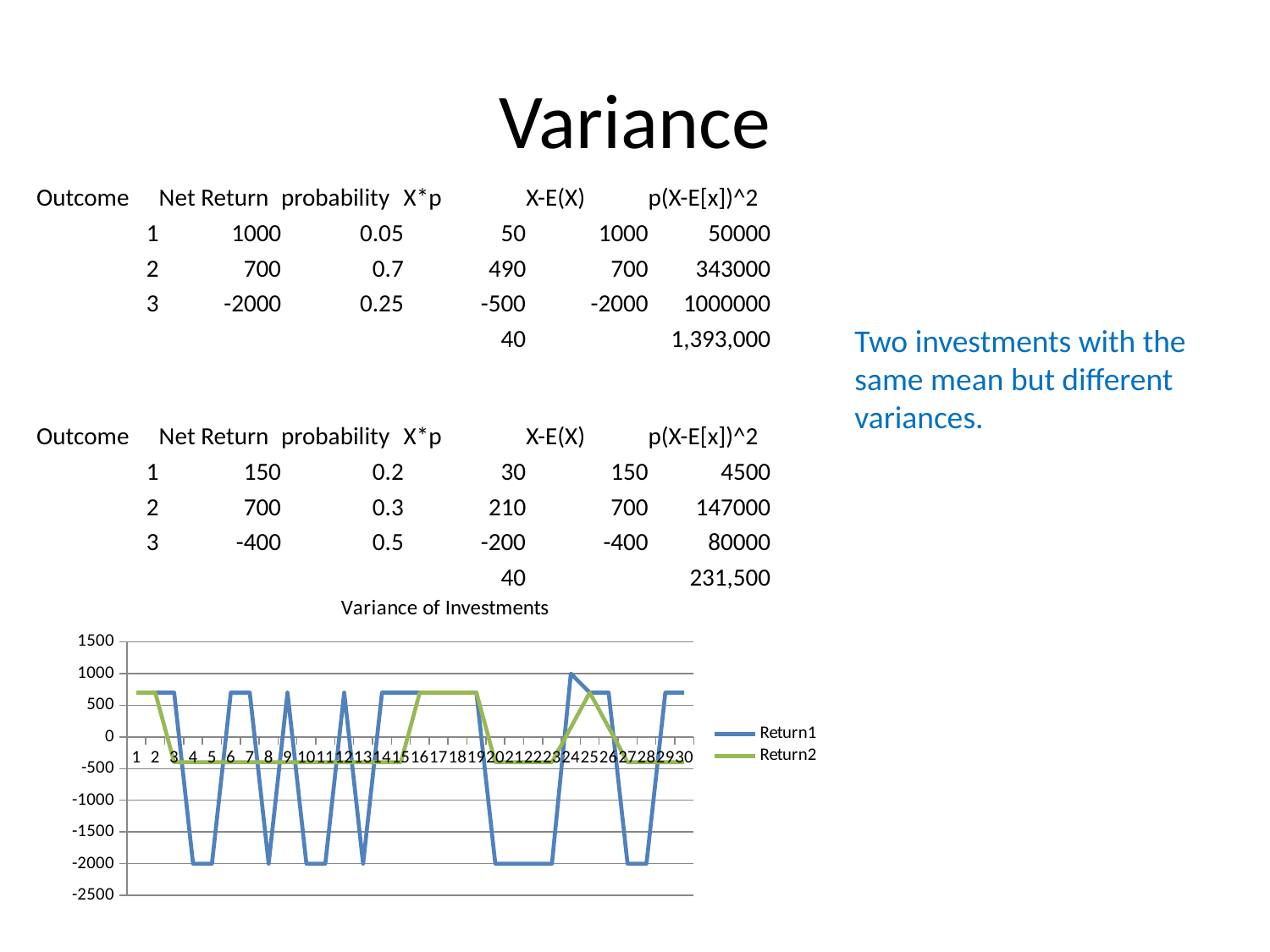
What is the title of the chart? Variance of Investments What are the names of the two series in the chart's legend? Return1 and Return2 How many series does the chart's legend list? 2 Is the value of Return2 at point 16 greater or less than 500? greater Is the value of Return2 at point 4 greater or less than 0? less At point 24, which series has the larger value, Return1 or Return2? Return1 How many points are plotted along the x axis of the chart? 30 What is the value of Return1 at point 24? 1000 What is the value of Return1 at point 4? -2000 At point 4, which series has the larger value, Return1 or Return2? Return2 What kind of chart is shown on the slide? line chart At which x-axis point does Return1 reach its highest value? 24